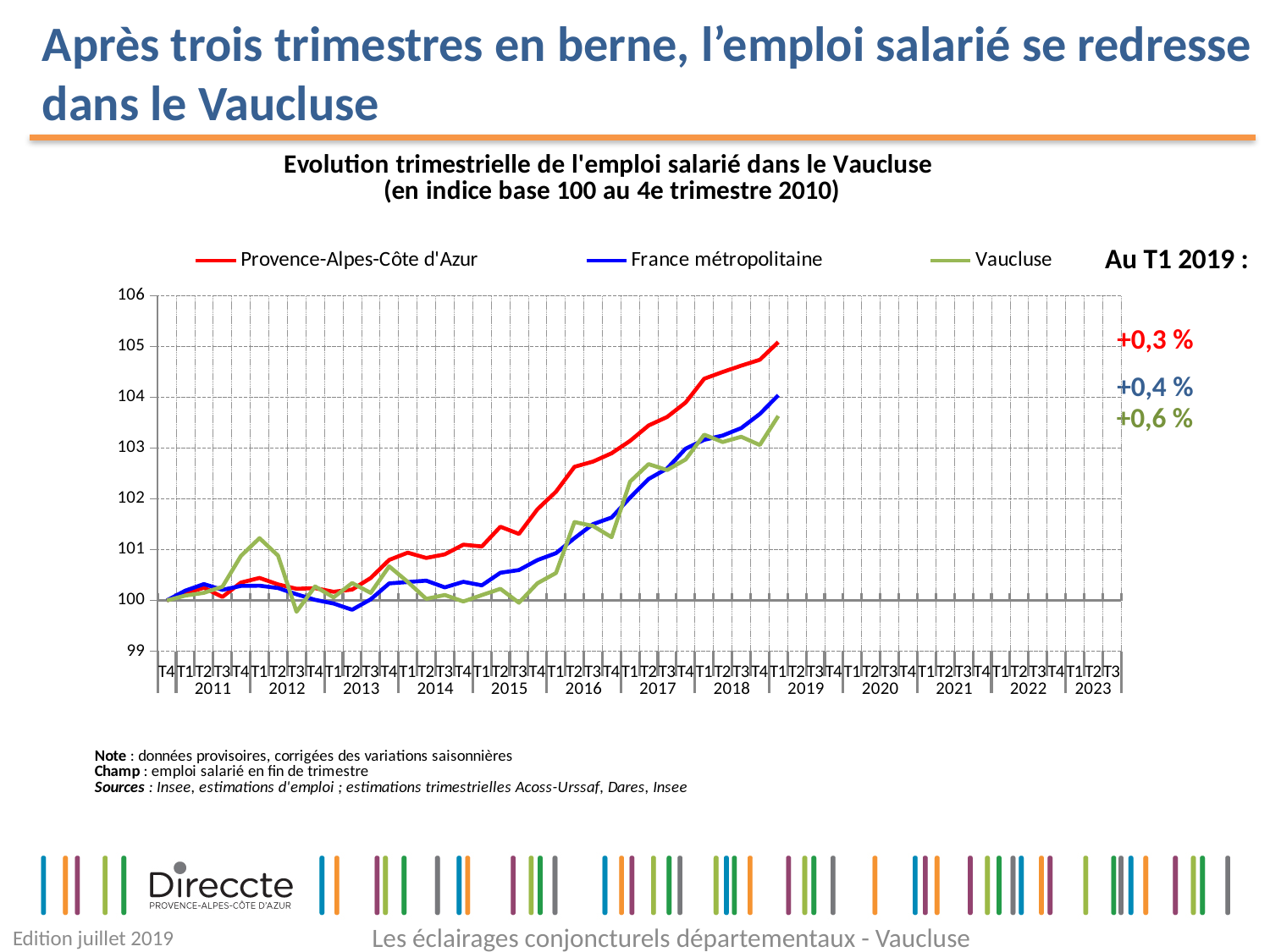
According to the annotation, what is the quarterly change for Provence-Alpes-Côte d'Azur at T1 2019? +0,3 % According to the annotation, what is the quarterly change for France métropolitaine at T1 2019? +0,4 % Which three series are listed in the chart legend? Provence-Alpes-Côte d'Azur, France métropolitaine, Vaucluse According to the annotation, what is the quarterly change for Vaucluse at T1 2019? +0,6 % Overall, do the index values rise or fall from T4 2010 to T1 2019? rise Is the index value for Vaucluse at T1 2019 greater or less than 104? less What kind of chart is shown on the slide? line chart What is the title of the chart? Evolution trimestrielle de l'emploi salarié dans le Vaucluse (en indice base 100 au 4e trimestre 2010) How many series does the chart legend list? 3 Is the index value for Provence-Alpes-Côte d'Azur at T1 2019 greater or less than 104? greater Which series has the lowest index value at T1 2019? Vaucluse Which series has the highest index value at T1 2019? Provence-Alpes-Côte d'Azur